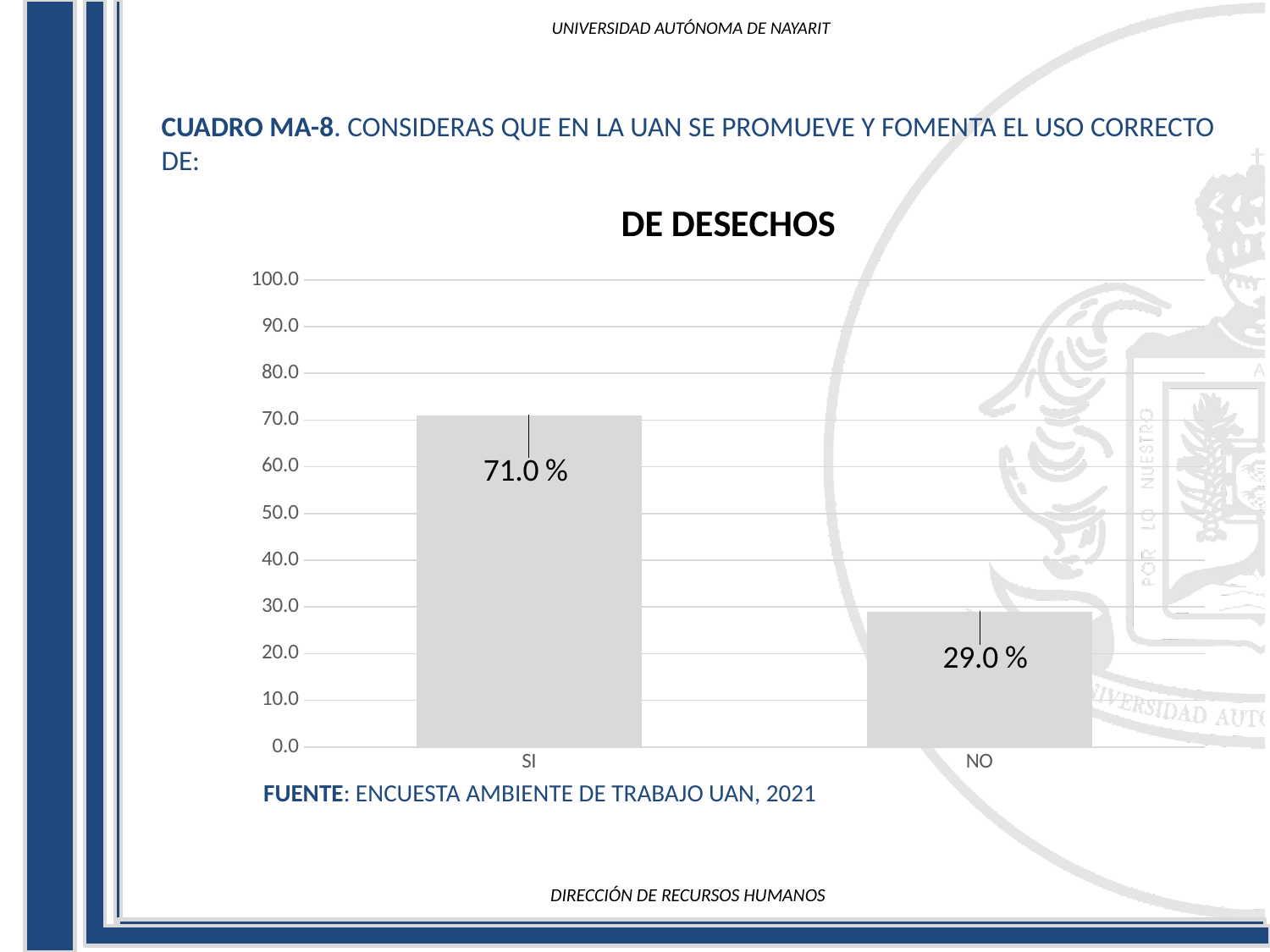
What is the title of the chart? DE DESECHOS What is the value for NO? 29.0 % What is the highest value shown on the y axis? 100.0 What kind of chart is shown? bar chart Which is larger, the value for SI or the value for NO? SI What is the difference between the values for SI and NO? 42.0 % Is the value for SI greater or less than 70.0? greater Which category has the lowest value? NO What is the value for SI? 71.0 % Which category has the highest value? SI How many categories are shown on the x axis? 2 Is the value for NO greater or less than 30.0? less